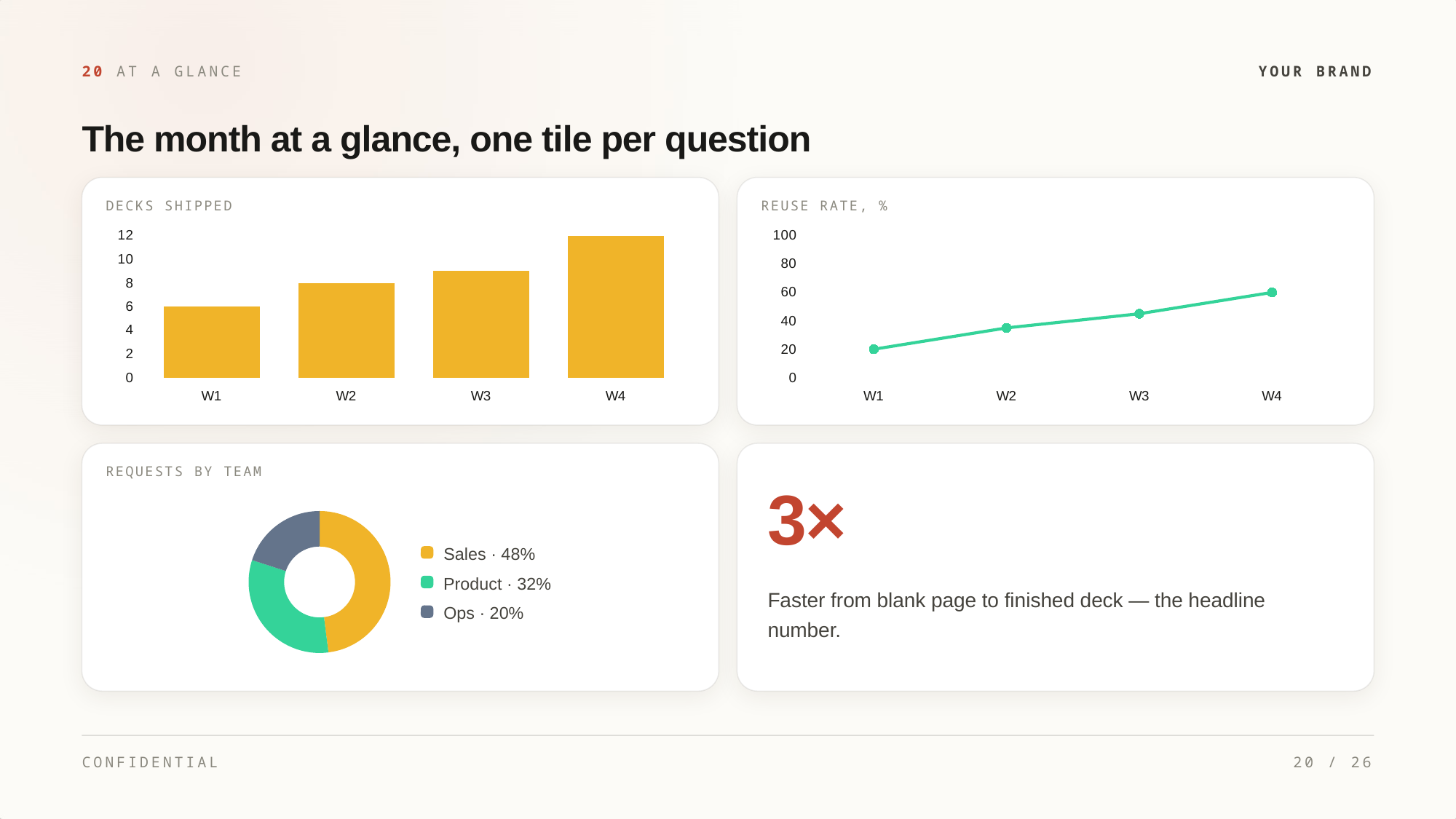
In the DECKS SHIPPED chart, what is the value for W4? 12 In the DECKS SHIPPED chart, what is the difference between W4 and W2? 4 In the DECKS SHIPPED chart, is the value for W3 greater or less than 10? less In the DECKS SHIPPED chart, what is the value for W1? 6 In the REQUESTS BY TEAM chart, what share does Product have? 32% In the REQUESTS BY TEAM chart, which team has the smallest share? Ops What kind of chart is the DECKS SHIPPED chart? bar chart In the REUSE RATE, % chart, what is the value for W4? 60 In the REUSE RATE, % chart, what is the value for W1? 20 In the REUSE RATE, % chart, is the value for W2 greater or less than 40? less In the REUSE RATE, % chart, do the values rise or fall from W1 to W4? rise In the DECKS SHIPPED chart, which week has the highest value? W4